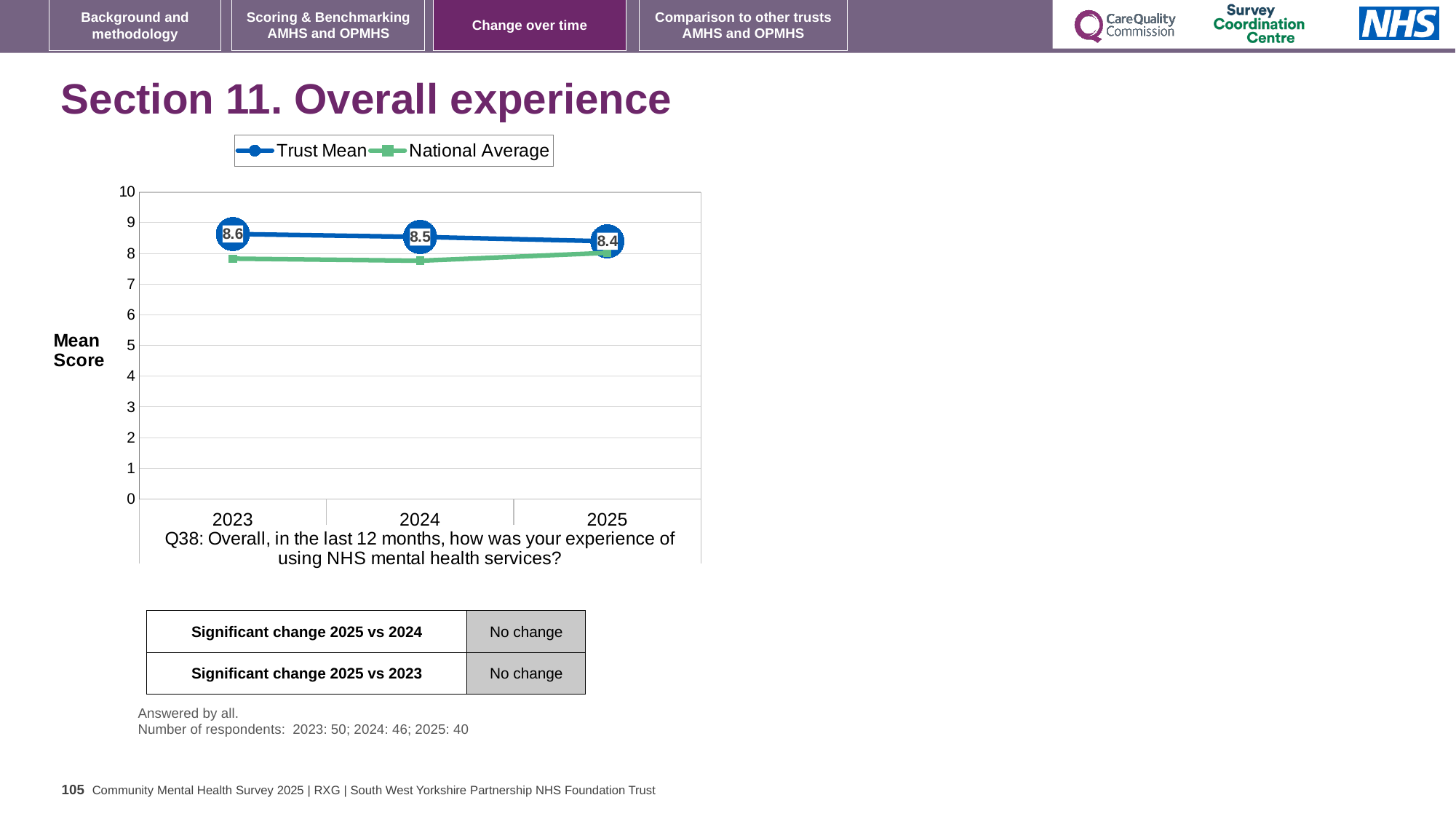
What is the Trust Mean value for 2023? 8.6 In which year is the Trust Mean highest? 2023 How many series does the legend list? 2 What is the difference between the Trust Mean in 2023 and in 2025? 0.2 In which year is the Trust Mean lowest? 2025 What is the Trust Mean value for 2025? 8.4 How many years are plotted on the x axis? 3 In 2023, which is larger: the Trust Mean or the National Average? Trust Mean Is the National Average value for 2024 greater or less than 7? greater What is the Trust Mean value for 2024? 8.5 Does the Trust Mean rise or fall from 2023 to 2025? Fall What kind of chart is shown on the slide? Line chart